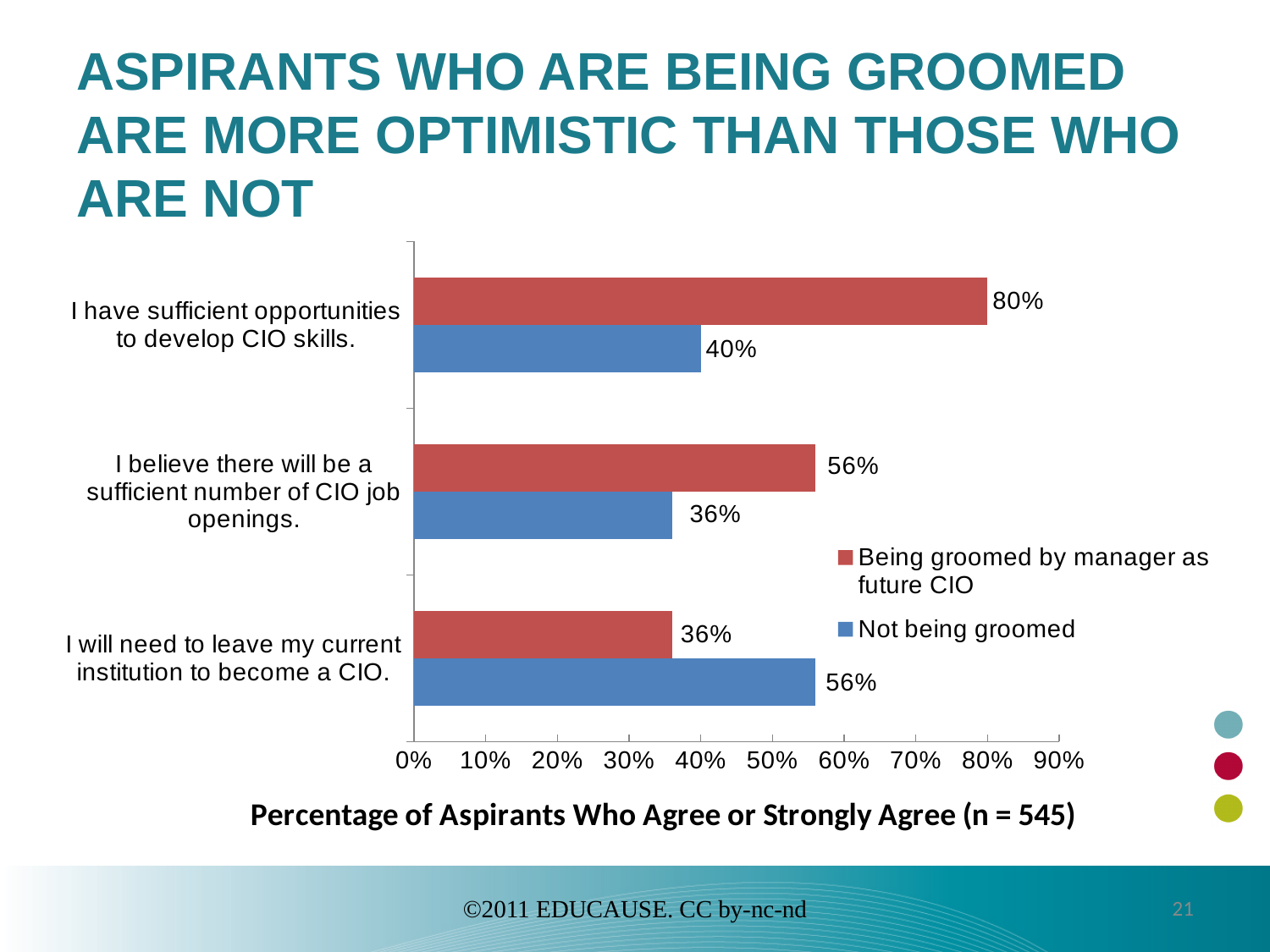
How many series does the legend list? 2 What kind of chart is shown on the slide? Bar chart What is the sample size (n) given in the chart's axis title? 545 What percentage of aspirants not being groomed agree that they have sufficient opportunities to develop CIO skills? 40% What is the difference between the 'Being groomed' and 'Not being groomed' values for 'I have sufficient opportunities to develop CIO skills'? 40% What percentage of aspirants not being groomed believe there will be a sufficient number of CIO job openings? 36% For which statement is the value for 'Being groomed by manager as future CIO' highest? I have sufficient opportunities to develop CIO skills. How many statements (categories) are shown on the chart? 3 For 'I will need to leave my current institution to become a CIO', which group has the larger value: being groomed or not being groomed? Not being groomed For which statement is the value for 'Not being groomed' lowest? I believe there will be a sufficient number of CIO job openings. What percentage of aspirants being groomed by a manager as future CIO agree that they have sufficient opportunities to develop CIO skills? 80% What percentage of aspirants being groomed by a manager agree they will need to leave their current institution to become a CIO? 36%